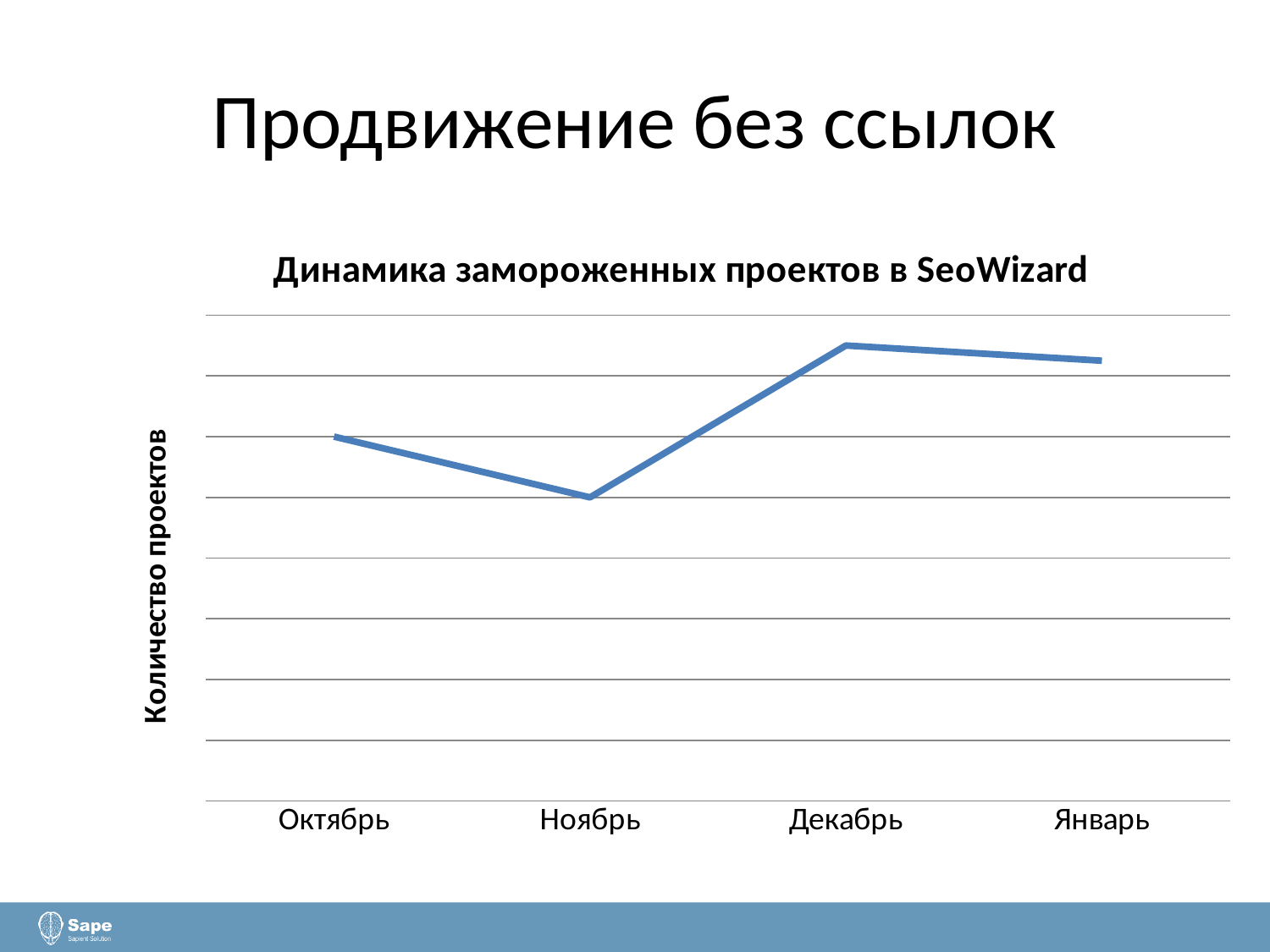
Does the line rise or fall from Ноябрь to Декабрь? rise How many months are plotted along the x axis of the chart? 4 Which month has the highest number of frozen projects in the chart? Декабрь Which is larger, the value for Октябрь or the value for Ноябрь? Октябрь Which is larger, the value for Январь or the value for Октябрь? Январь Which month has the lowest number of frozen projects in the chart? Ноябрь What kind of chart is shown on the slide? line chart What is the label on the vertical axis of the chart? Количество проектов Does the line rise or fall from Октябрь to Ноябрь? fall Does the line rise or fall from Декабрь to Январь? fall What is the title of the chart? Динамика замороженных проектов в SeoWizard Which is larger, the value for Декабрь or the value for Ноябрь? Декабрь